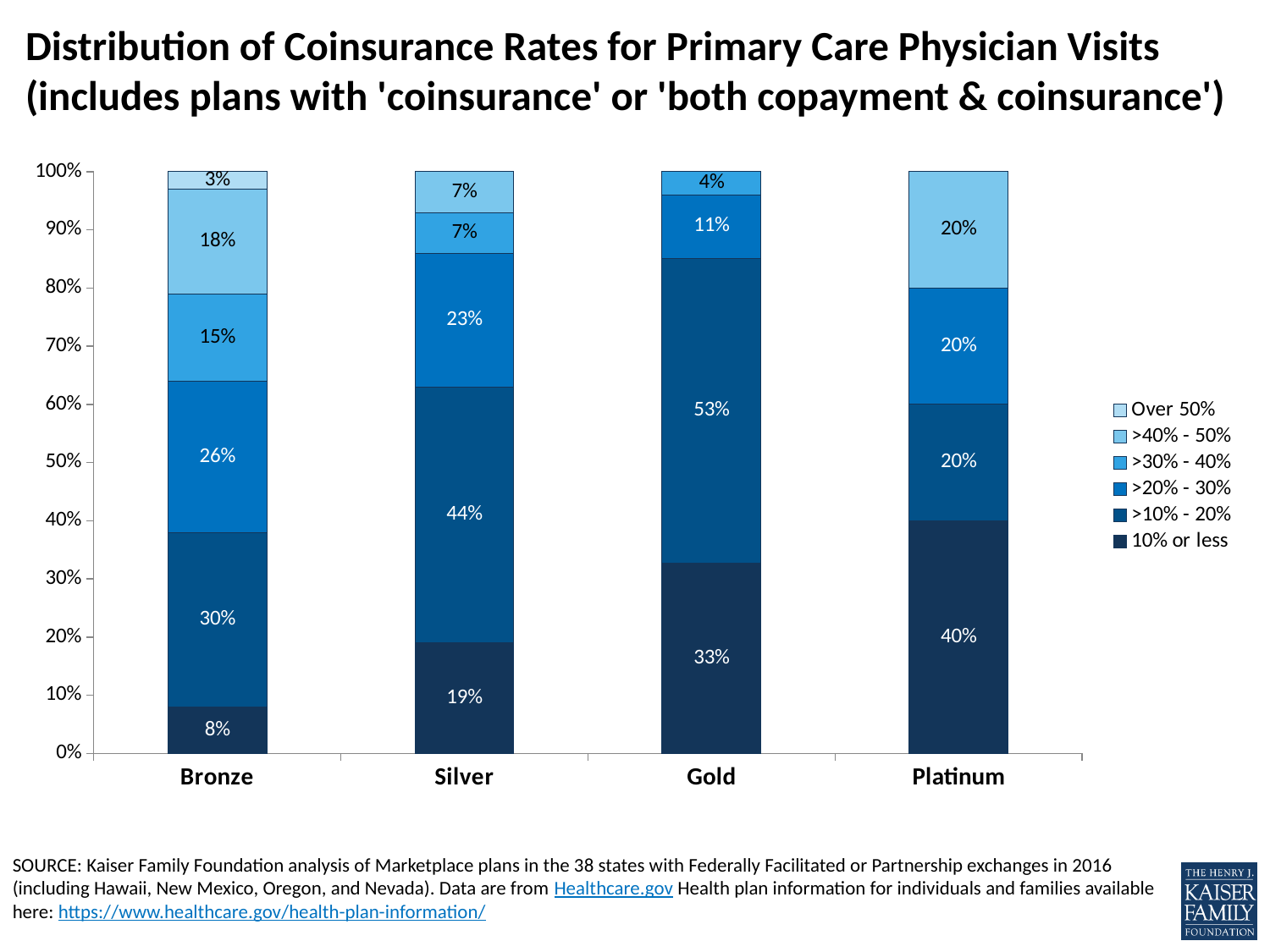
What share of Bronze plans have a coinsurance rate of 10% or less? 8% Which plan type has the largest share of plans with coinsurance of 10% or less? Platinum What share of Gold plans fall in the >10% - 20% coinsurance band? 53% Which plan type has the smallest share of plans with coinsurance of 10% or less? Bronze Which is larger: the >10% - 20% share for Silver or for Gold? Gold What kind of chart is shown on the slide? Stacked bar chart Does the share of plans with coinsurance of 10% or less rise or fall from Bronze to Platinum? Rise What is the difference in percentage points between the Gold and Bronze shares for the 10% or less band? 25 percentage points How many plan categories are shown on the x axis? 4 How many series does the legend list? 6 What share of Platinum plans have a coinsurance rate of 10% or less? 40% What share of Silver plans fall in the >10% - 20% coinsurance band? 44%